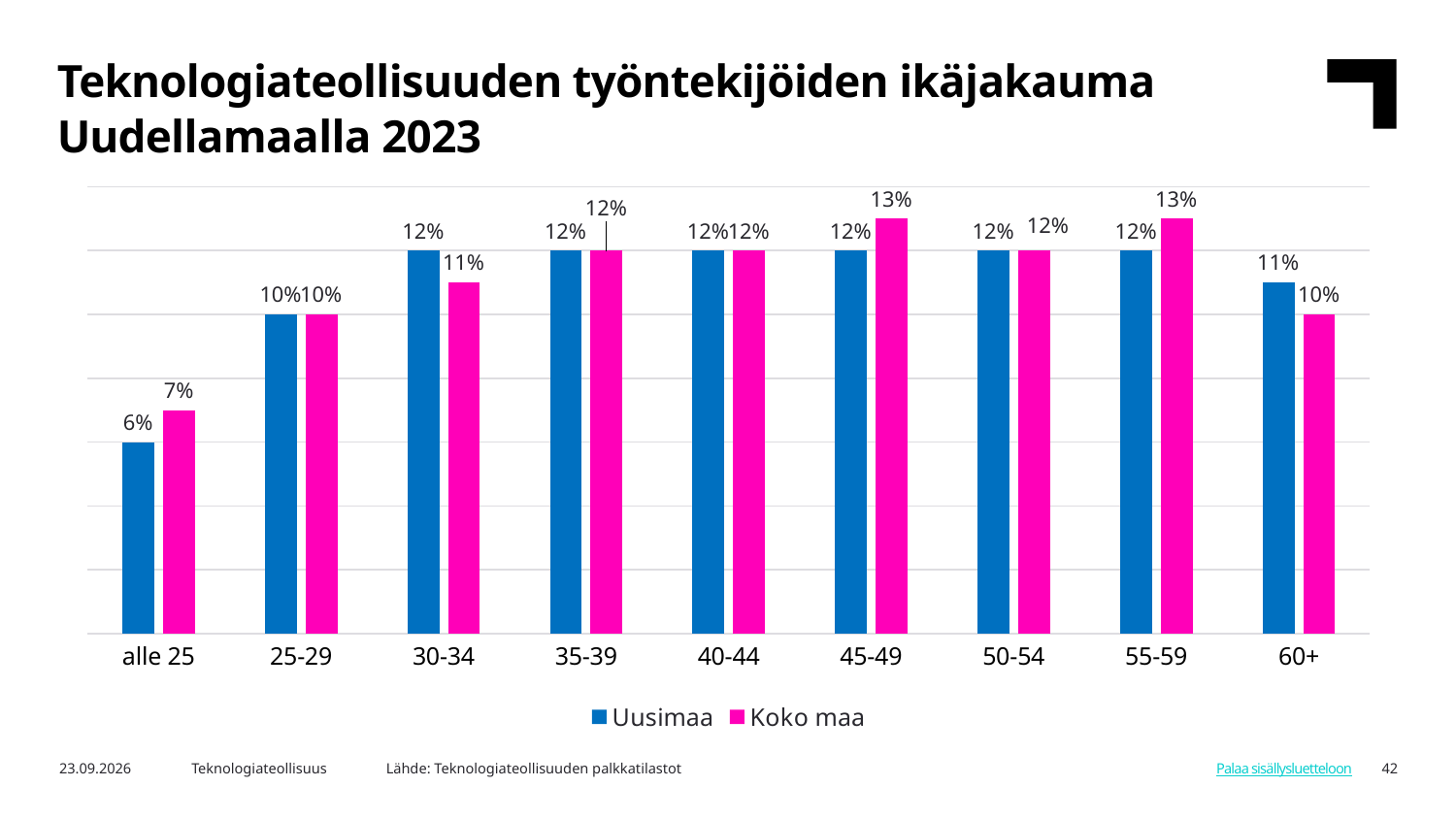
How many series does the legend list? 2 What is the Koko maa value for the '45-49' age group? 13% Which age group has the lowest Uusimaa value? alle 25 Which age group has the lowest Koko maa value? alle 25 What type of chart is shown on the slide? Bar chart What is the Koko maa value for the '30-34' age group? 11% What is the Uusimaa value for the '60+' age group? 11% What is the Uusimaa value for the 'alle 25' age group? 6% What is the difference between the Uusimaa and Koko maa values for the '60+' age group? 1 percentage point Which series is shown in pink in the legend? Koko maa For the 'alle 25' age group, which is larger: Uusimaa or Koko maa? Koko maa How many age categories are shown on the x axis? 9